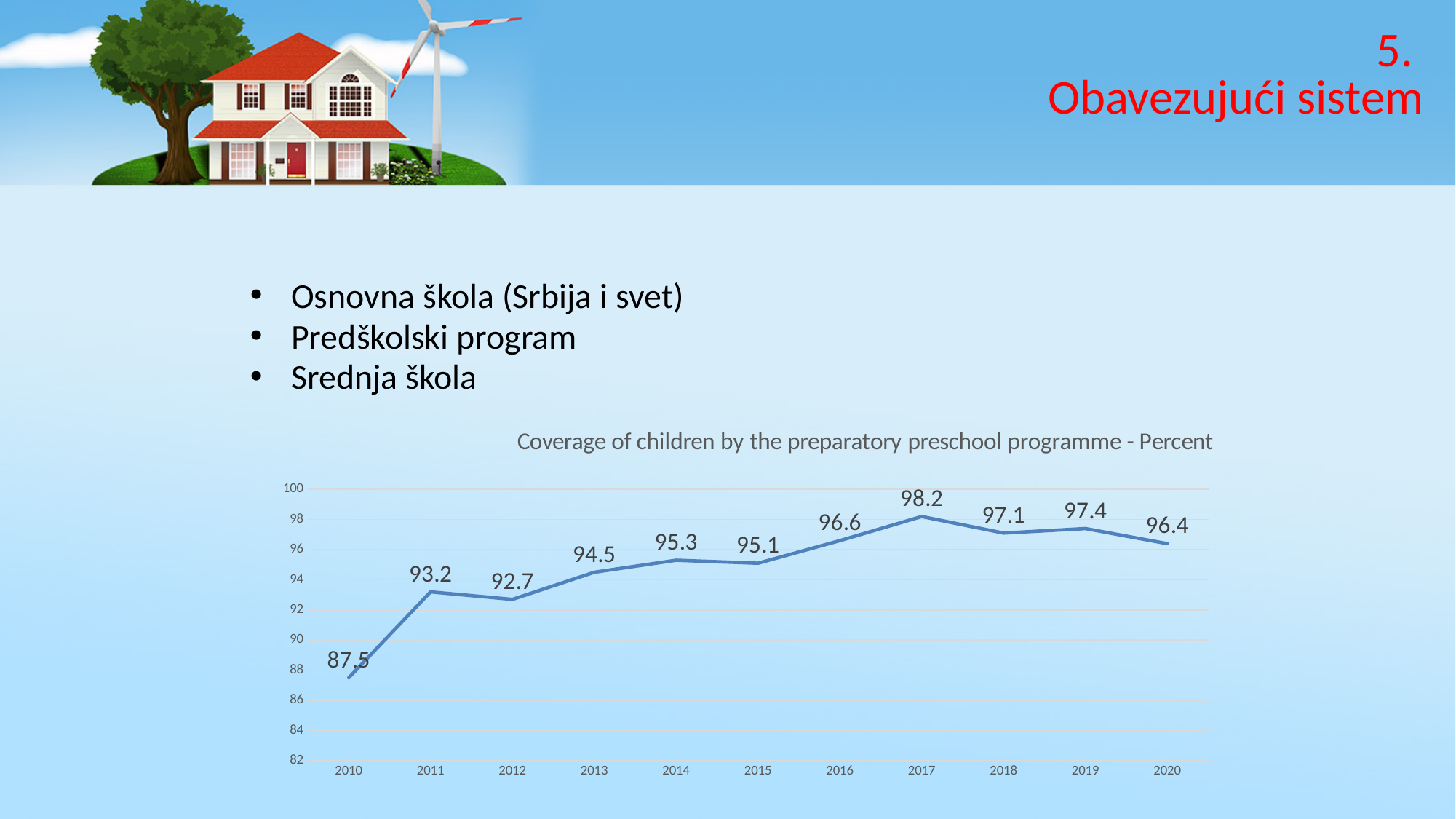
Which year has a higher coverage value, 2011 or 2012? 2011 What is the title of the chart? Coverage of children by the preparatory preschool programme - Percent Which year has the lowest coverage value? 2010 What is the coverage value for 2010? 87.5 What kind of chart is shown on the slide? Line chart Which year has the highest coverage value? 2017 What is the difference between the coverage values for 2017 and 2010? 10.7 Is the value for 2013 greater or less than 94? greater Does the coverage value rise or fall from 2010 to 2011? Rise How many years are plotted on the chart? 11 What is the coverage value for 2020? 96.4 What is the coverage value for 2017? 98.2